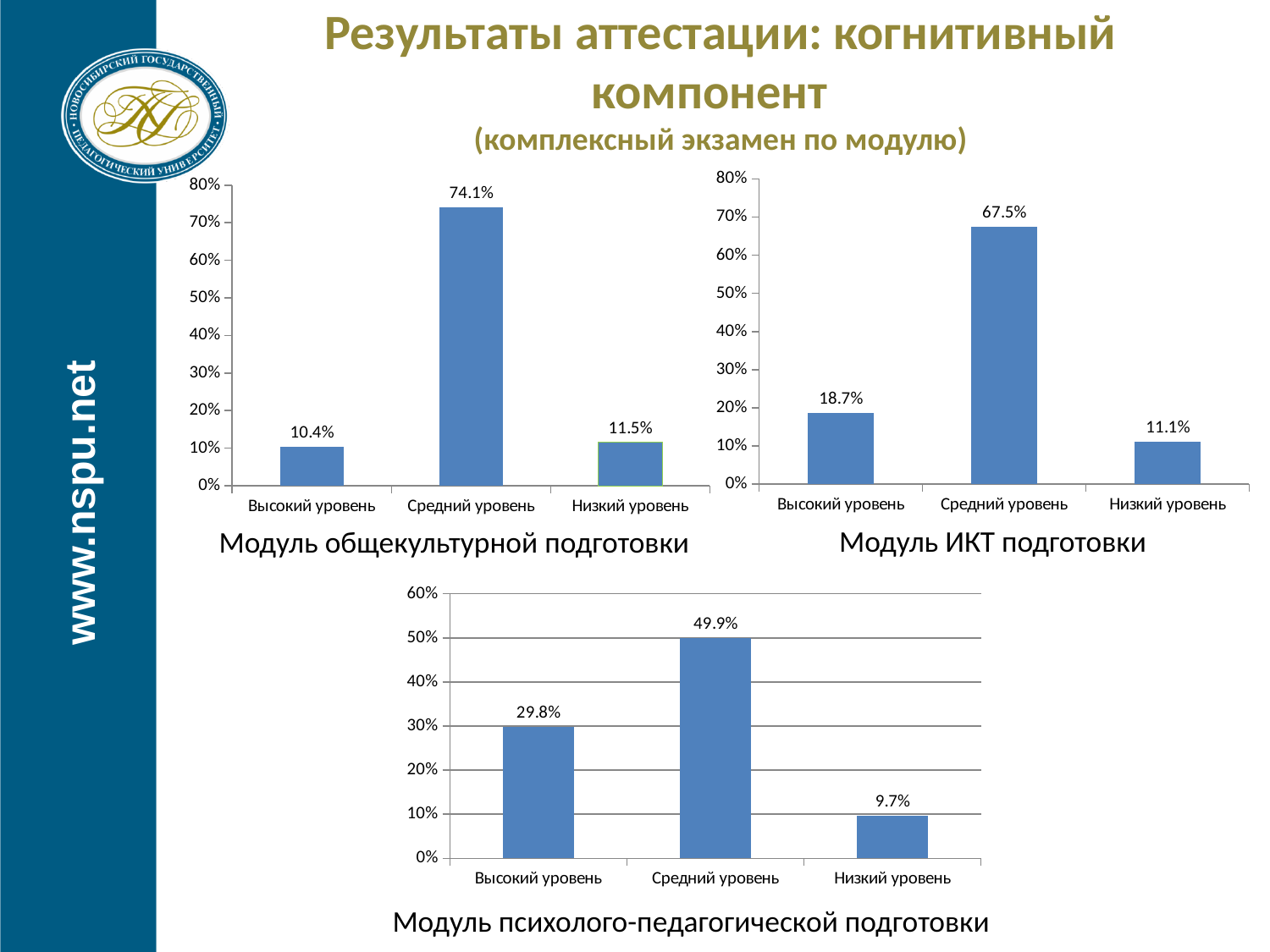
In the chart 'Модуль общекультурной подготовки', which category has the lowest value? Высокий уровень What kind of chart is 'Модуль ИКТ подготовки'? Bar chart In the chart 'Модуль ИКТ подготовки', what is the value for Высокий уровень? 18.7% In the chart 'Модуль ИКТ подготовки', which is larger: Высокий уровень or Низкий уровень? Высокий уровень In the chart 'Модуль общекультурной подготовки', what is the difference between Низкий уровень and Высокий уровень? 1.1% In the chart 'Модуль психолого-педагогической подготовки', what is the value for Высокий уровень? 29.8% In the chart 'Модуль психолого-педагогической подготовки', is the value for Средний уровень greater or less than 40%? greater In the chart 'Модуль ИКТ подготовки', what is the difference between Средний уровень and Низкий уровень? 56.4% In the chart 'Модуль общекультурной подготовки', what is the value for Средний уровень? 74.1% In the chart 'Модуль психолого-педагогической подготовки', what is the value for Низкий уровень? 9.7% In the chart 'Модуль ИКТ подготовки', which category has the highest value? Средний уровень How many categories does the chart 'Модуль психолого-педагогической подготовки' show? 3